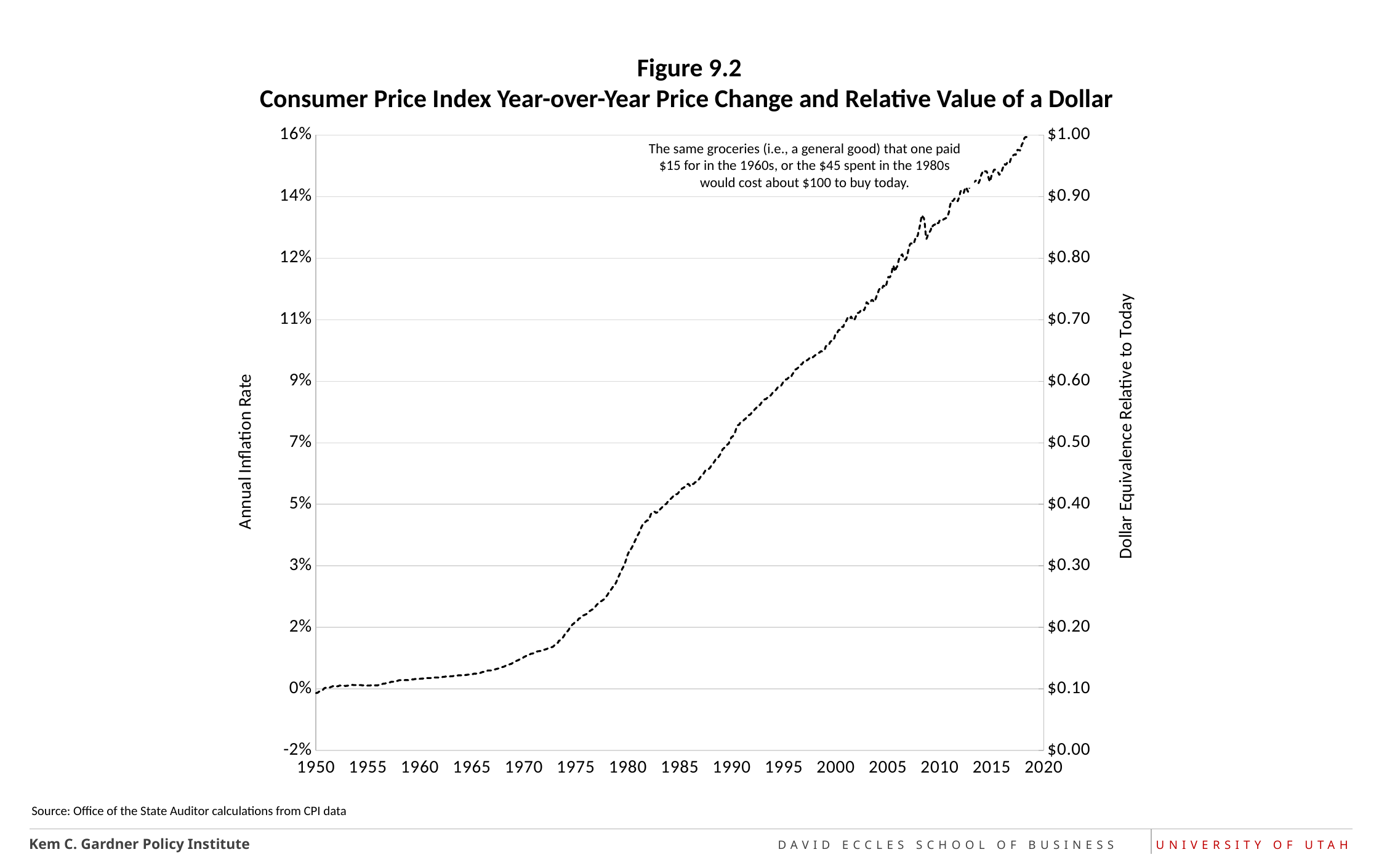
Does the dashed line for Dollar Equivalence Relative to Today rise or fall from 1950 to 2020? rise According to the annotation on the chart, about how much would the groceries that cost $15 in the 1960s cost today? about $100 Is the Dollar Equivalence Relative to Today value in 1970 greater or less than $0.20? less What is the highest value shown on the right-hand axis? $1.00 Is the Dollar Equivalence Relative to Today value in 1960 greater or less than $0.20? less Is the Dollar Equivalence Relative to Today value in 1985 greater or less than $0.50? less How many year labels are shown on the x axis? 15 Which year has a higher Dollar Equivalence Relative to Today value, 1975 or 1995? 1995 What kind of chart is shown on the slide? line chart